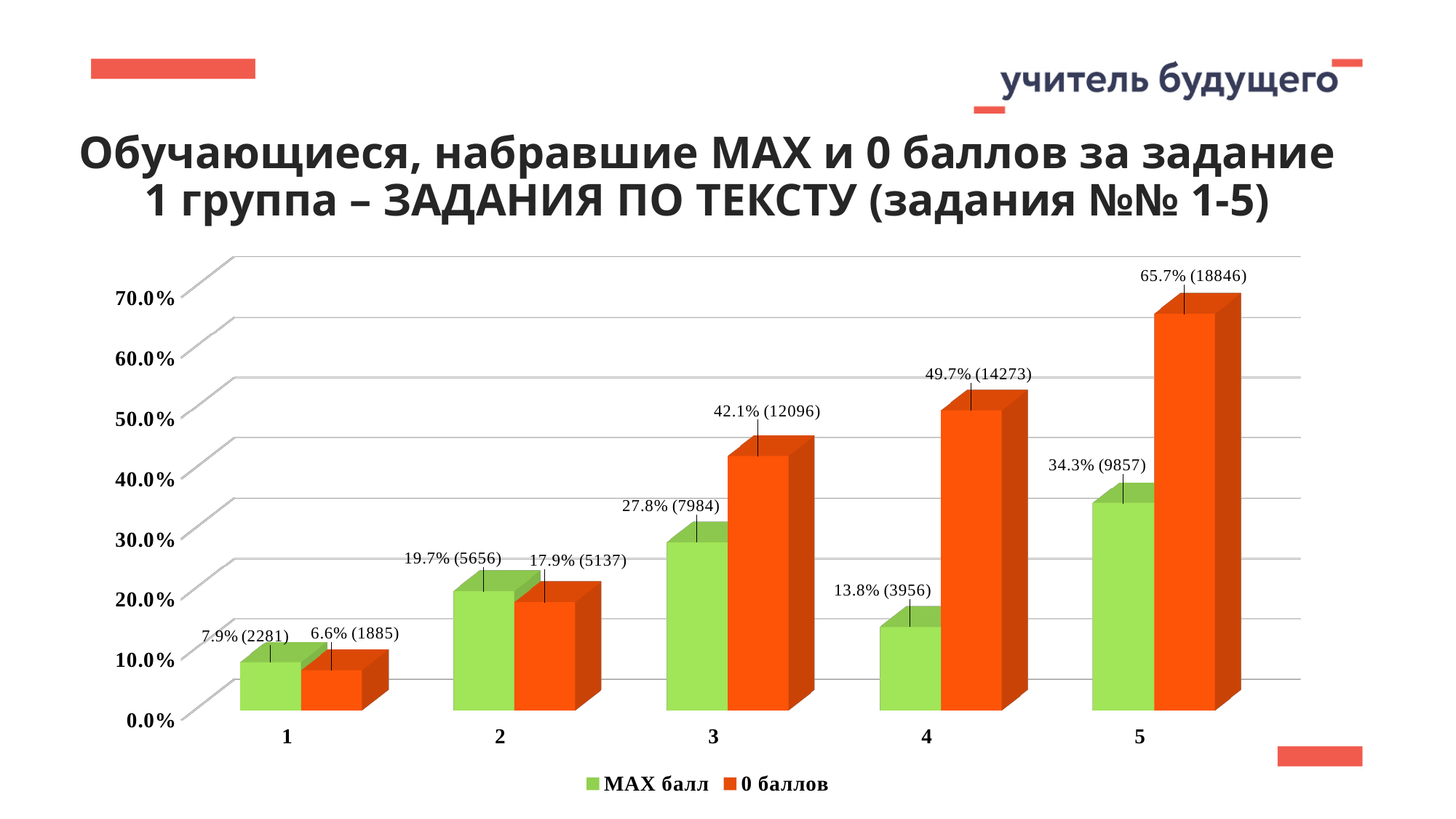
Which task has the lowest value for "MAX балл"? 1 What is the value for "MAX балл" for task 3? 27.8% (7984) What is the difference in percentage points between "0 баллов" and "MAX балл" for task 4? 35.9% Which task has the highest value for "0 баллов"? 5 How many tasks (categories) are shown on the x axis? 5 What is the value for "MAX балл" for task 4? 13.8% (3956) For task 2, which series has the larger value, "MAX балл" or "0 баллов"? MAX балл What kind of chart is shown on the slide? Bar chart What is the value for "0 баллов" for task 5? 65.7% (18846) How many series does the legend list? 2 Which colour represents the "0 баллов" series? Orange What is the value for "0 баллов" for task 1? 6.6% (1885)